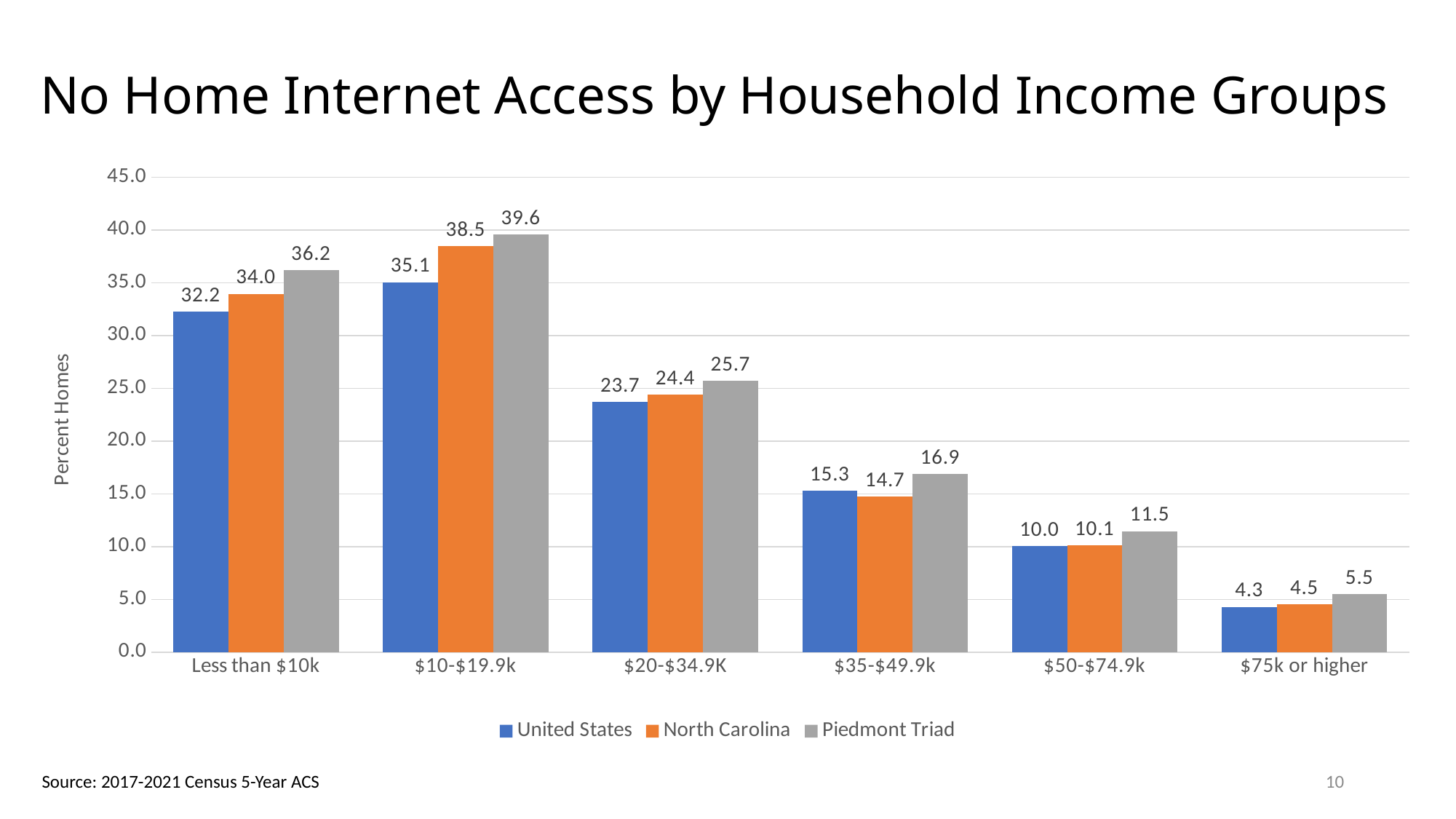
How many series does the legend list? 3 Is the value for North Carolina in the $10-$19.9k income group greater or less than 35.0? greater Do the Piedmont Triad values rise or fall from the $10-$19.9k group to the $75k or higher group? Fall Which income group has the highest value for Piedmont Triad? $10-$19.9k Which income group has the lowest value for United States? $75k or higher What kind of chart is shown on the slide? Bar chart What is the difference between the Piedmont Triad and United States values in the $20-$34.9K income group? 2.0 What is the value for Piedmont Triad in the $10-$19.9k income group? 39.6 In the $35-$49.9k income group, which is larger: the United States value or the North Carolina value? United States What is the value for United States in the $35-$49.9k income group? 15.3 What is the value for North Carolina in the $75k or higher income group? 4.5 How many income groups are shown on the x axis? 6